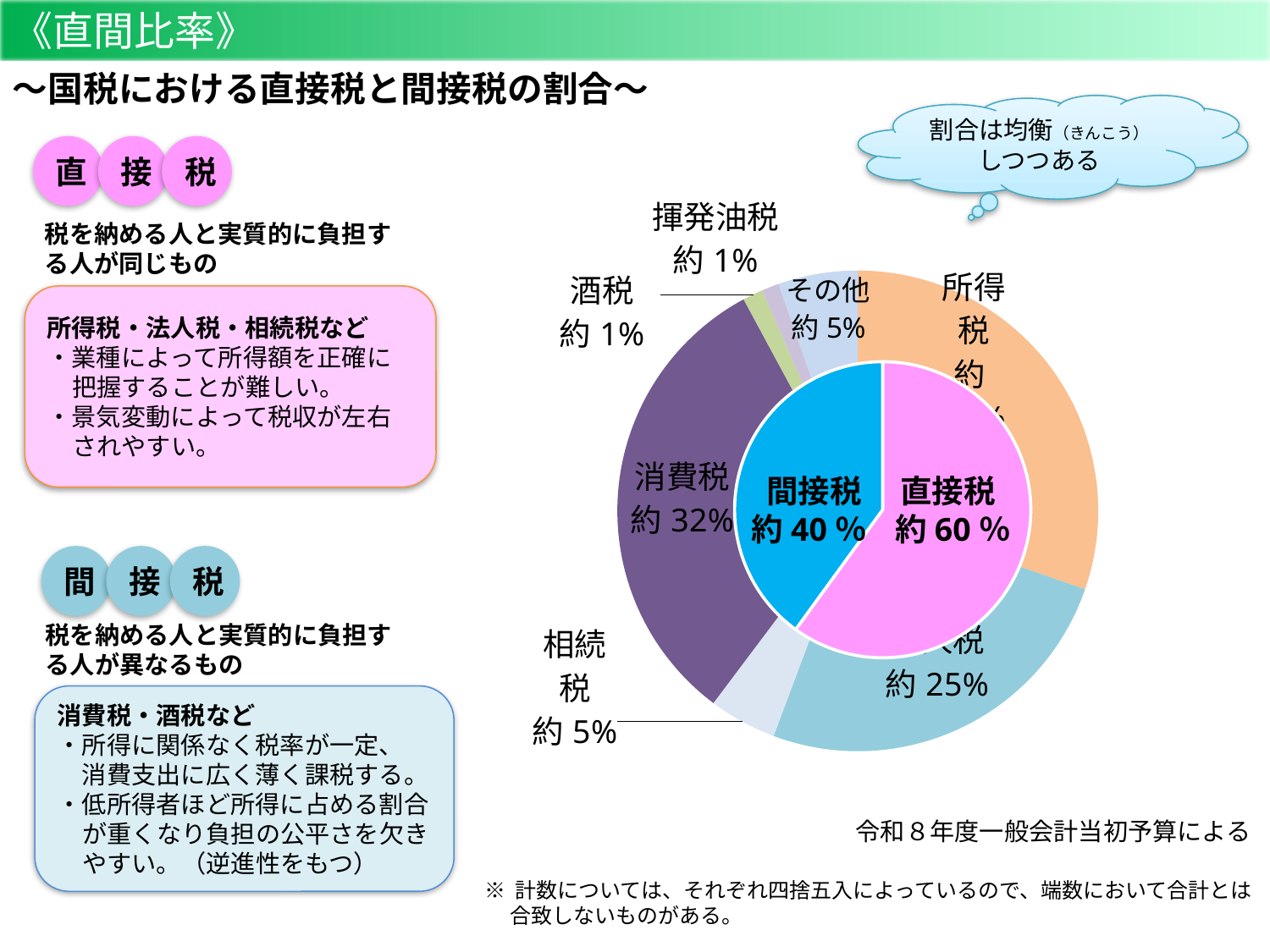
What kind of chart is shown on the slide? pie chart By how many percentage points does 直接税 exceed 間接税 in the inner ring of the chart? 20 How many segments does the outer ring of the chart have? 7 What is the share shown for 直接税 in the inner ring of the chart? 約 60 % What is the share shown for 酒税 in the chart? 約 1% What is the share shown for 相続税 in the chart? 約 5% What is the share shown for 間接税 in the inner ring of the chart? 約 40 % What is the share shown for その他 in the chart? 約 5% What is the share shown for 揮発油税 in the chart? 約 1% What is the share shown for 消費税 in the outer ring of the chart? 約 32% According to the note below the chart, which budget is the chart based on? 令和８年度一般会計当初予算 Which is larger in the inner ring of the chart, 直接税 or 間接税? 直接税